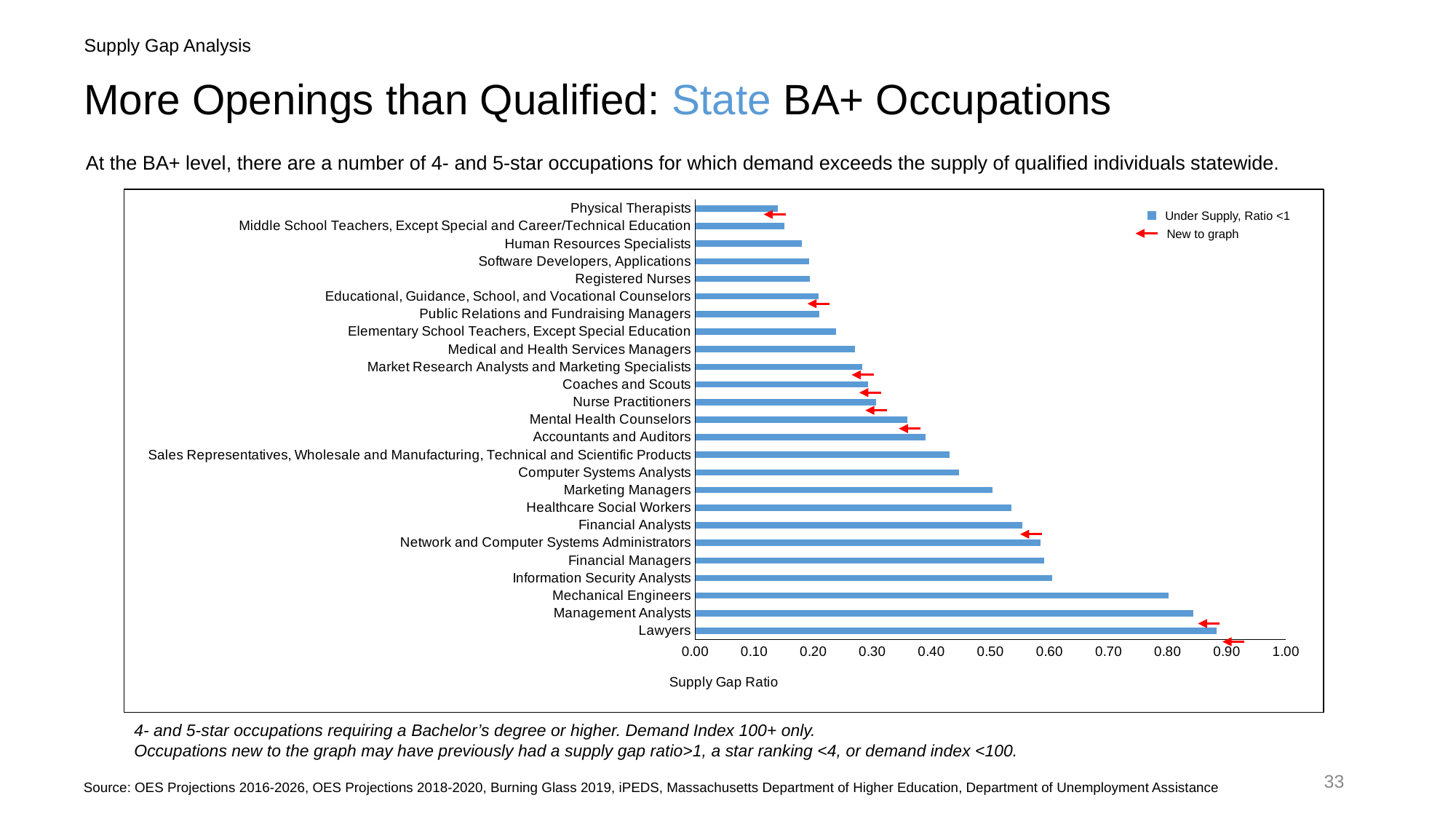
What is the title of the horizontal axis? Supply Gap Ratio How many occupations are plotted in the chart? 25 Which occupation has the highest supply gap ratio? Lawyers Which occupation has the lowest supply gap ratio? Physical Therapists Is the supply gap ratio for Computer Systems Analysts greater or less than 0.50? less Is the supply gap ratio for Healthcare Social Workers greater or less than 0.50? greater Is the supply gap ratio for Elementary School Teachers, Except Special Education greater or less than 0.20? greater What kind of chart is shown on the slide? Bar chart Which has a larger supply gap ratio, Mechanical Engineers or Information Security Analysts? Mechanical Engineers According to the legend, what do the red arrows indicate? New to graph